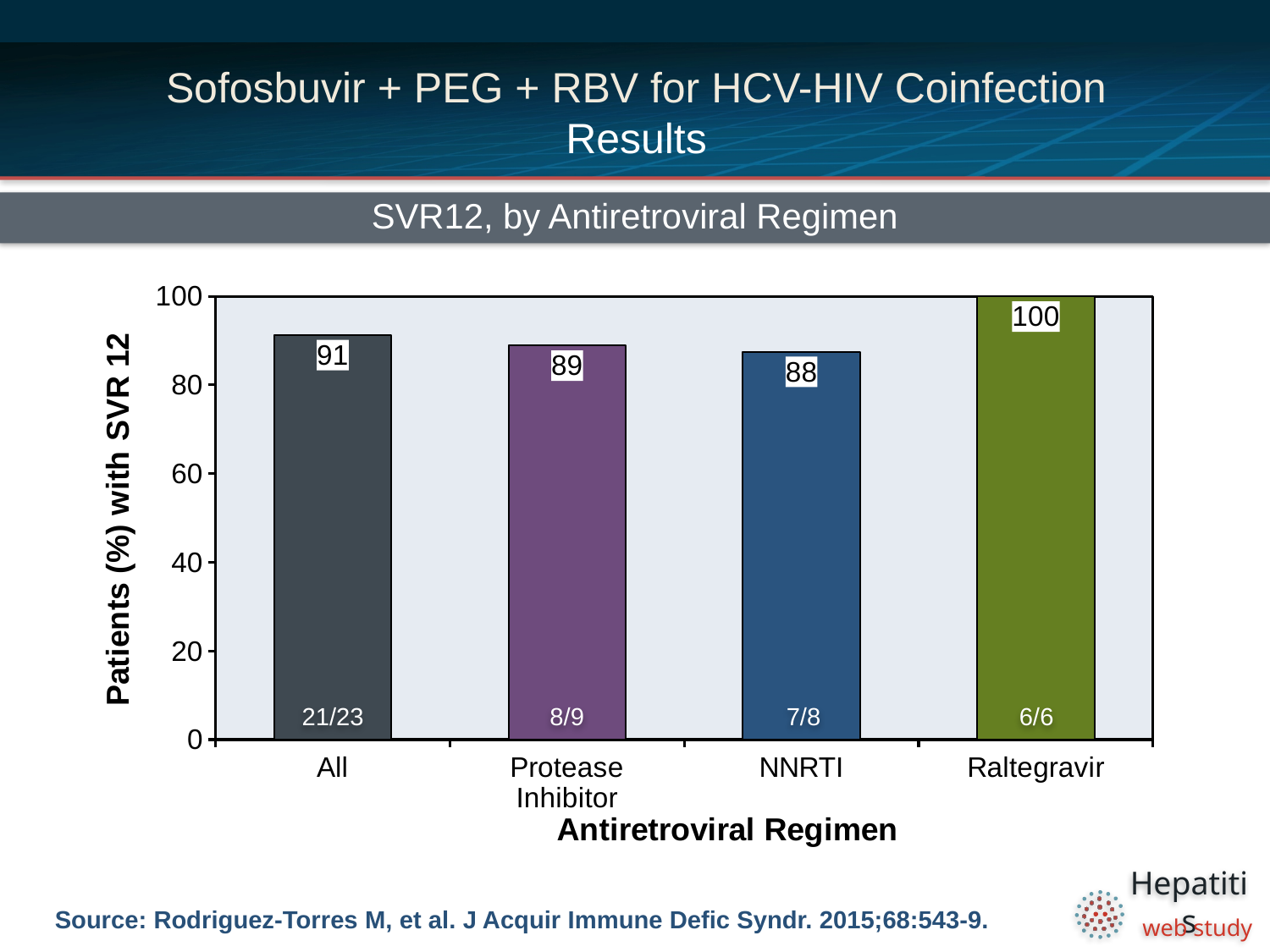
What is the SVR12 rate (%) for the NNRTI group? 88 What is the SVR12 rate (%) for patients on a Protease Inhibitor regimen? 89 What is the difference in SVR12 rate (percentage points) between Raltegravir and NNRTI? 12 Which antiretroviral regimen has the highest SVR12 rate? Raltegravir What is the label of the y-axis? Patients (%) with SVR 12 Which has a higher SVR12 rate, the All group or the Protease Inhibitor group? All What is the title of the chart? SVR12, by Antiretroviral Regimen What is the SVR12 rate (%) for the All group? 91 How many antiretroviral regimen categories are shown on the chart? 4 Which antiretroviral regimen has the lowest SVR12 rate? NNRTI What fraction of patients achieved SVR12 in the Raltegravir group? 6/6 What type of chart is used to show SVR12 by antiretroviral regimen? Bar chart